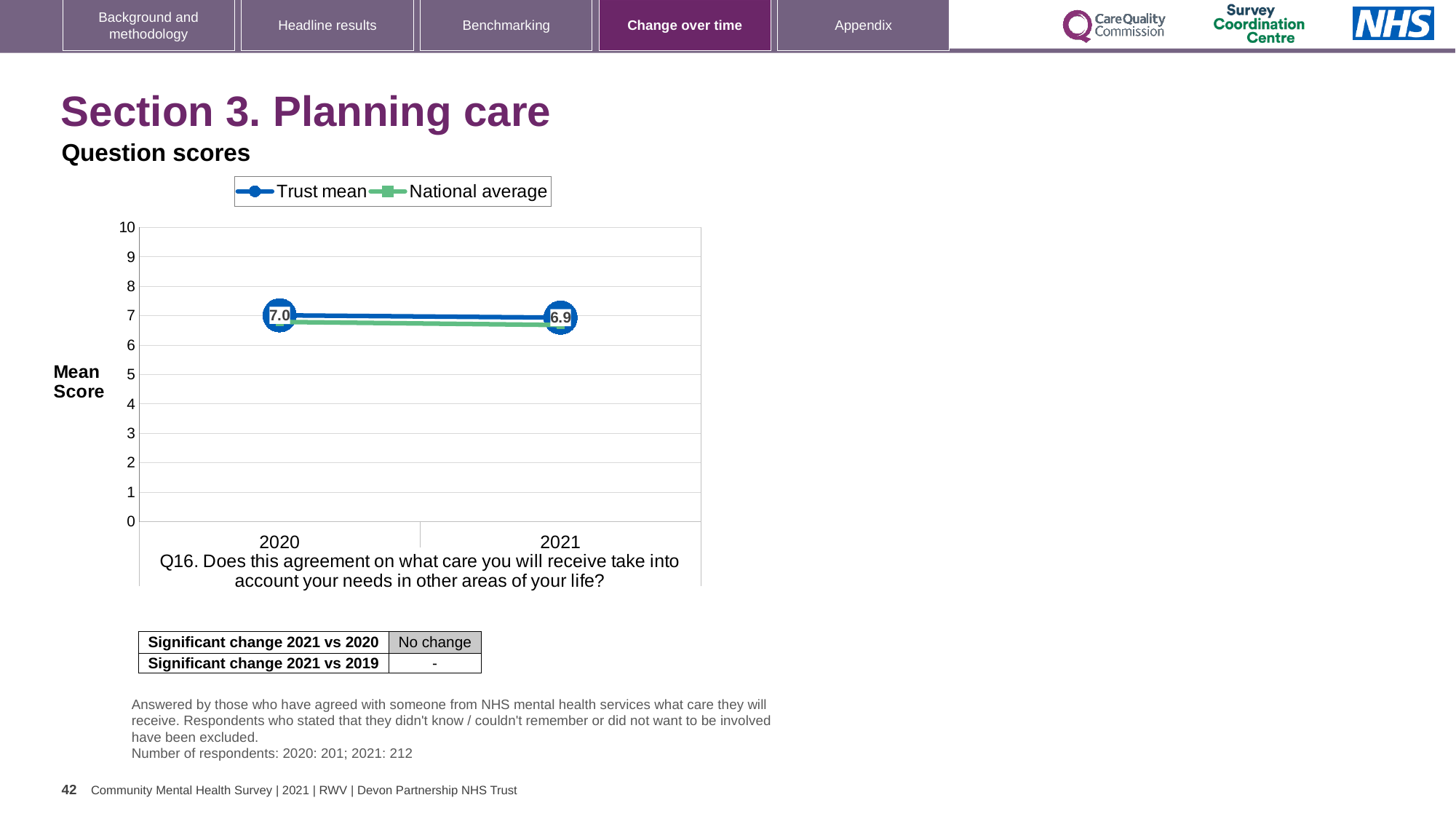
Which year has the higher Trust mean, 2020 or 2021? 2020 Is the National average value for 2020 greater or less than 5? greater What kind of chart is shown on the slide? line chart What is the difference between the Trust mean in 2020 and in 2021? 0.1 How many years are plotted on the x axis? 2 What is the Trust mean value for 2020? 7.0 Does the Trust mean rise or fall from 2020 to 2021? fall In which year is the Trust mean highest? 2020 How many series does the legend list? 2 Is the National average value for 2021 greater or less than 8? less What is the label on the y axis of the chart? Mean Score What is the Trust mean value for 2021? 6.9